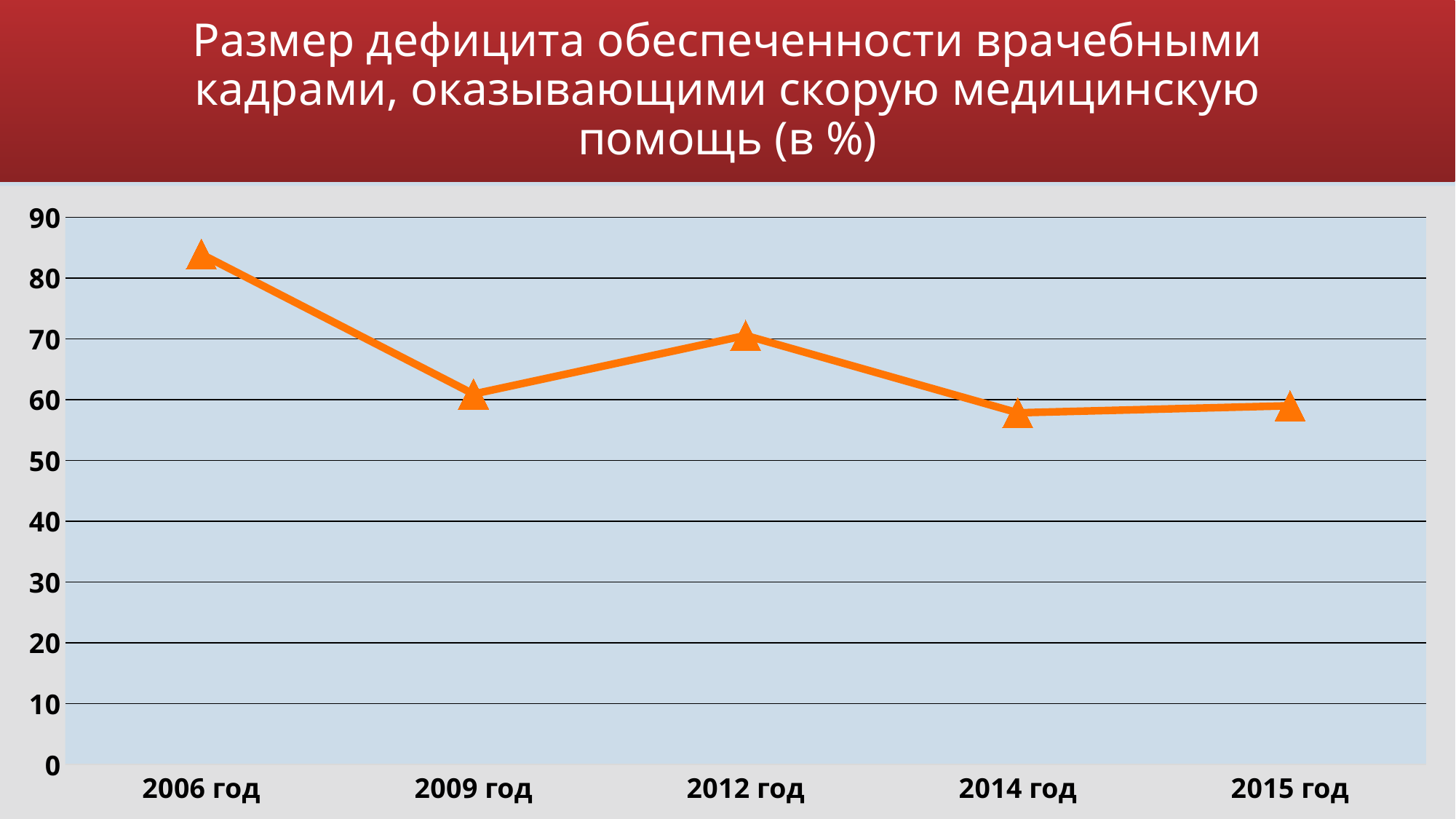
Is the value for 2015 год greater or less than 70? less Which is larger, the value for 2012 год or the value for 2014 год? 2012 год Which is larger, the value for 2006 год or the value for 2009 год? 2006 год What kind of chart is shown on the slide? line chart Which year has the highest value? 2006 год Is the value for 2014 год greater or less than 50? greater What shape are the data point markers on the line? triangles Overall, do the values rise or fall from 2006 год to 2015 год? fall Is the value for 2009 год greater or less than 70? less How many years are plotted on the x axis? 5